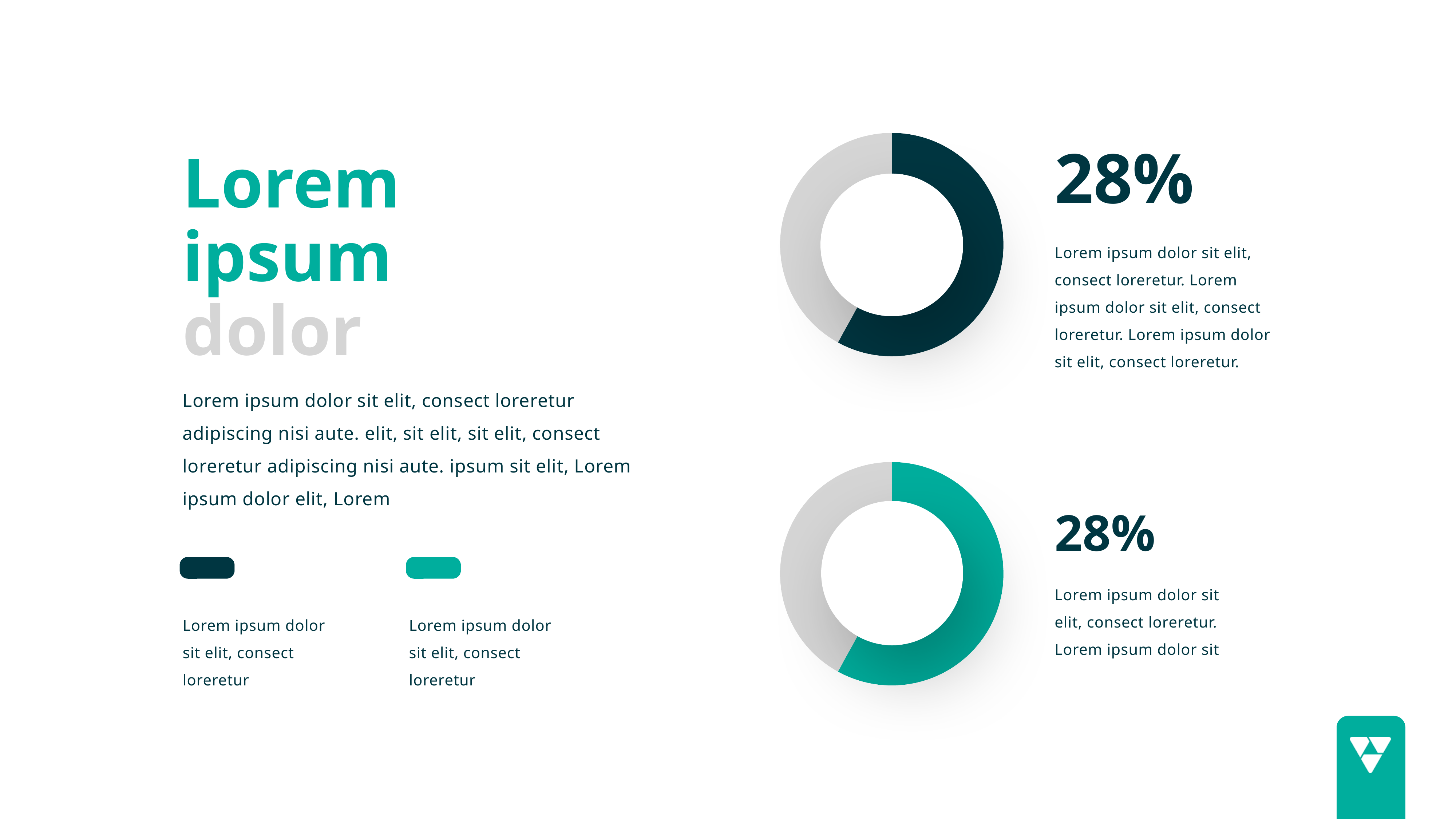
What kind of chart is shown at the bottom right of the slide? donut chart How many colour swatches does the legend on the left of the slide show? 2 What percentage is printed next to the bottom donut chart? 28% What percentage is printed next to the top donut chart? 28% How many donut charts are on the slide? 2 What colour is the highlighted segment of the bottom donut chart? teal What kind of chart is shown at the top right of the slide? donut chart Is the percentage printed next to the top donut chart the same as the one printed next to the bottom donut chart? yes What colour is the highlighted segment of the top donut chart? dark teal